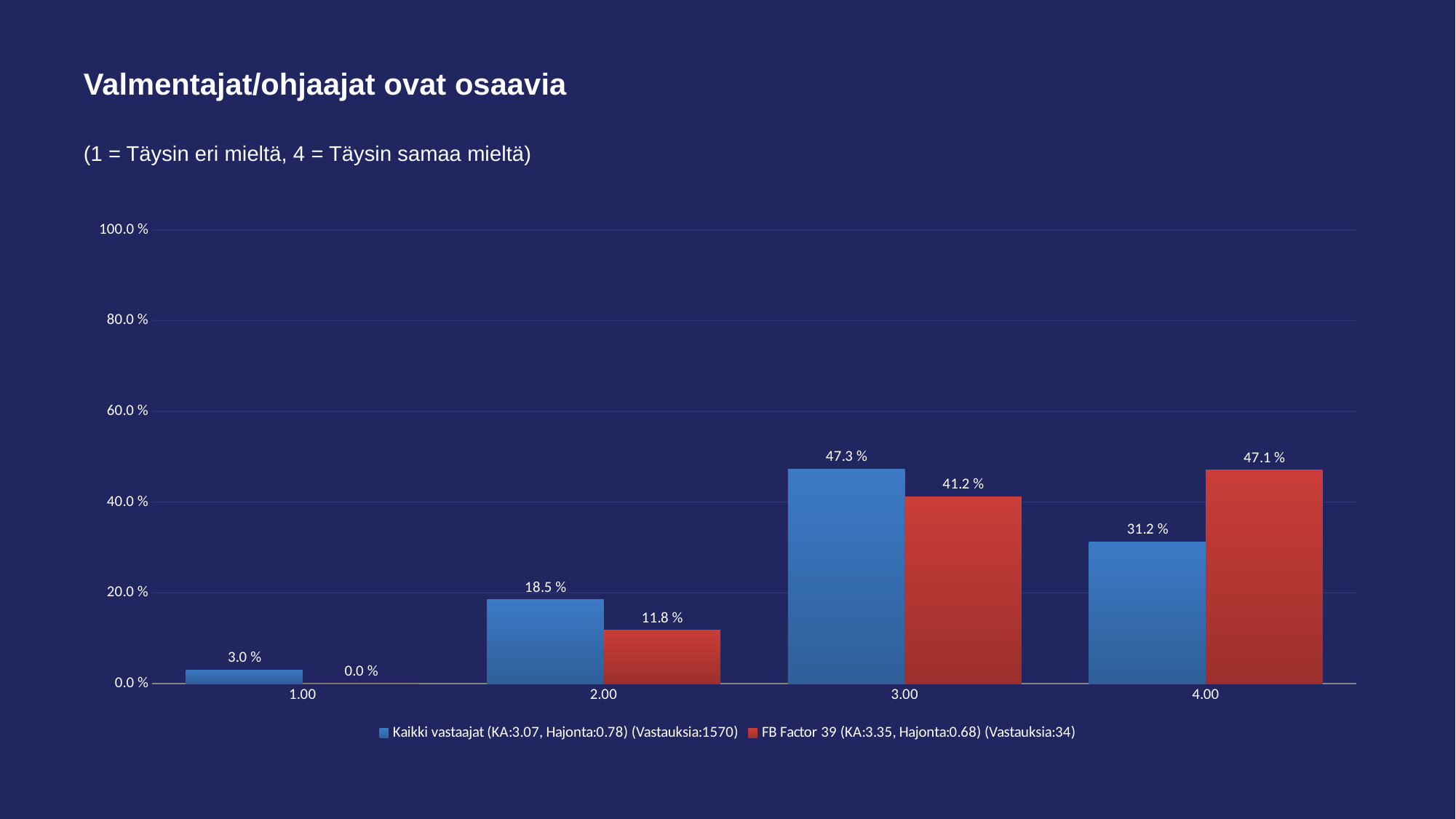
What kind of chart is shown on the slide? Bar chart What is the difference between Kaikki vastaajat and FB Factor 39 at 4.00? 15.9 % What is the value for Kaikki vastaajat at 3.00? 47.3 % Which category has the lowest value for FB Factor 39? 1.00 How many categories are shown on the x axis? 4 What is the value for Kaikki vastaajat at 2.00? 18.5 % At 2.00, which series has the larger value, Kaikki vastaajat or FB Factor 39? Kaikki vastaajat Which category has the highest value for Kaikki vastaajat? 3.00 What is the value for FB Factor 39 at 4.00? 47.1 % What is the value for FB Factor 39 at 1.00? 0.0 % What is the title of the chart? Valmentajat/ohjaajat ovat osaavia How many series does the legend list? 2